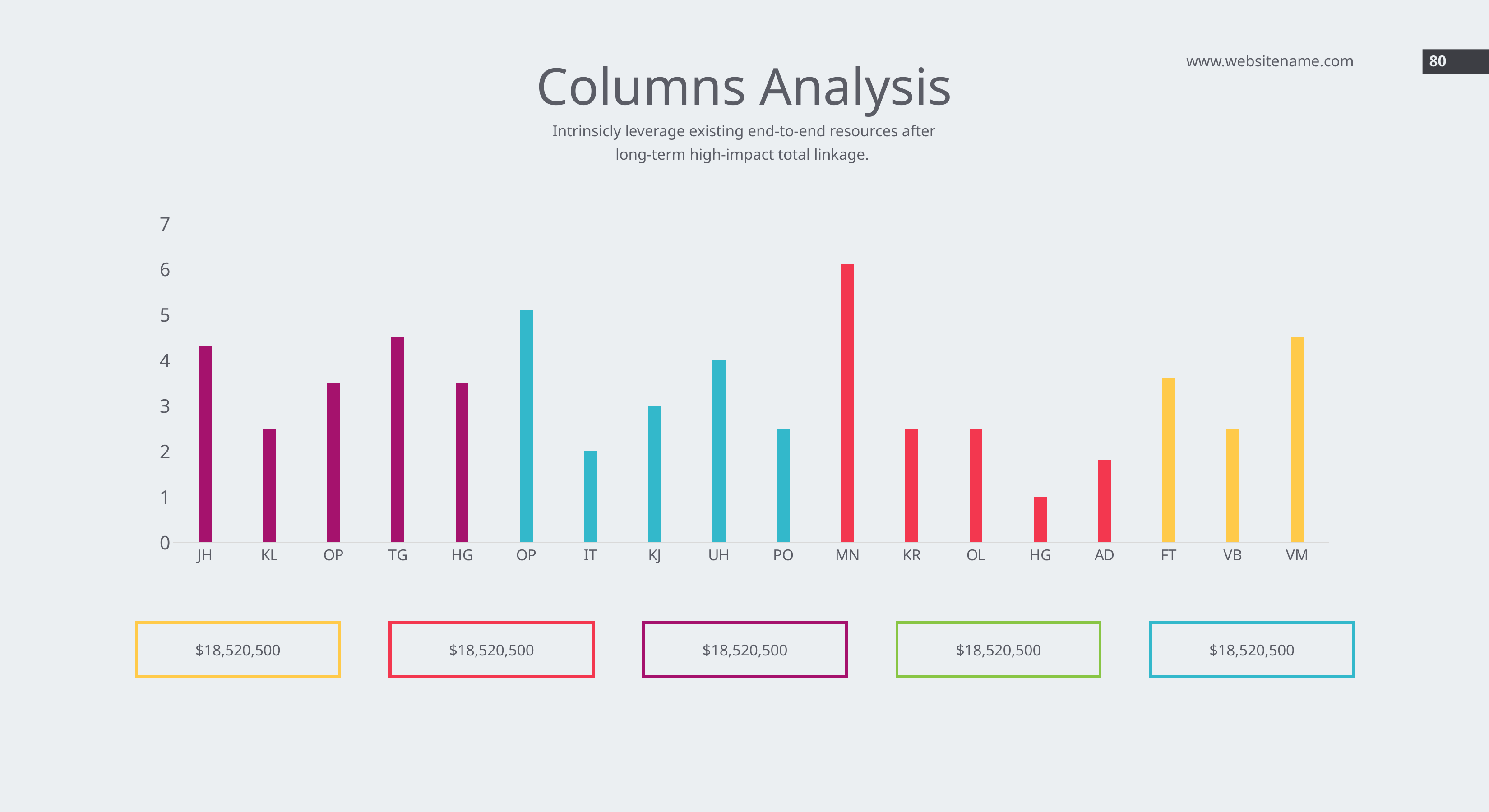
Is the value for KL greater or less than 3? less Is the value for JH greater or less than 4? greater What is the title of the chart on the slide? Columns Analysis How many bars (categories) are plotted in the chart? 18 Which category has the highest bar in the chart? MN Which is larger, the value for TG or the value for KL? TG Is the value for FT greater or less than 3? greater What is the highest value shown on the vertical axis of the chart? 7 Which category has the lowest bar in the chart? HG Which is larger, the value for VM or the value for VB? VM What kind of chart is shown on the slide? bar chart